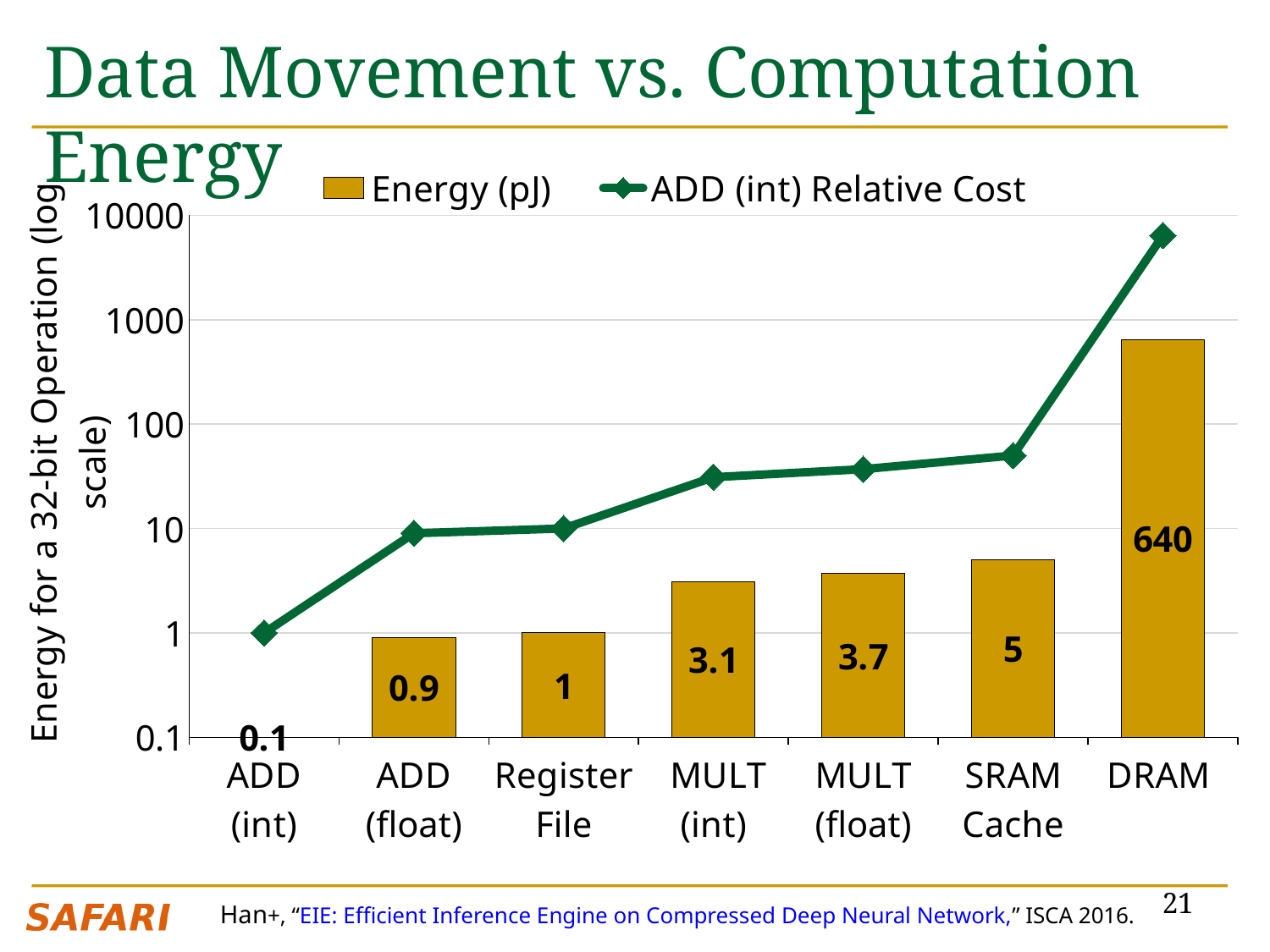
Which category has the highest Energy (pJ) value? DRAM How many series does the legend list? 2 What is the Energy (pJ) value for SRAM Cache? 5 What is the Energy (pJ) value for DRAM? 640 What is the difference in Energy (pJ) between DRAM and SRAM Cache? 635 Is the ADD (int) Relative Cost value for DRAM greater or less than 1000? greater Is the ADD (int) Relative Cost value for SRAM Cache greater or less than 100? less Which category has the lowest Energy (pJ) value? ADD (int) What is the Energy (pJ) value for MULT (float)? 3.7 Do the Energy (pJ) values rise or fall from left to right along the x axis? rise How many categories are shown on the x axis? 7 Which has a larger Energy (pJ) value, MULT (int) or ADD (float)? MULT (int)